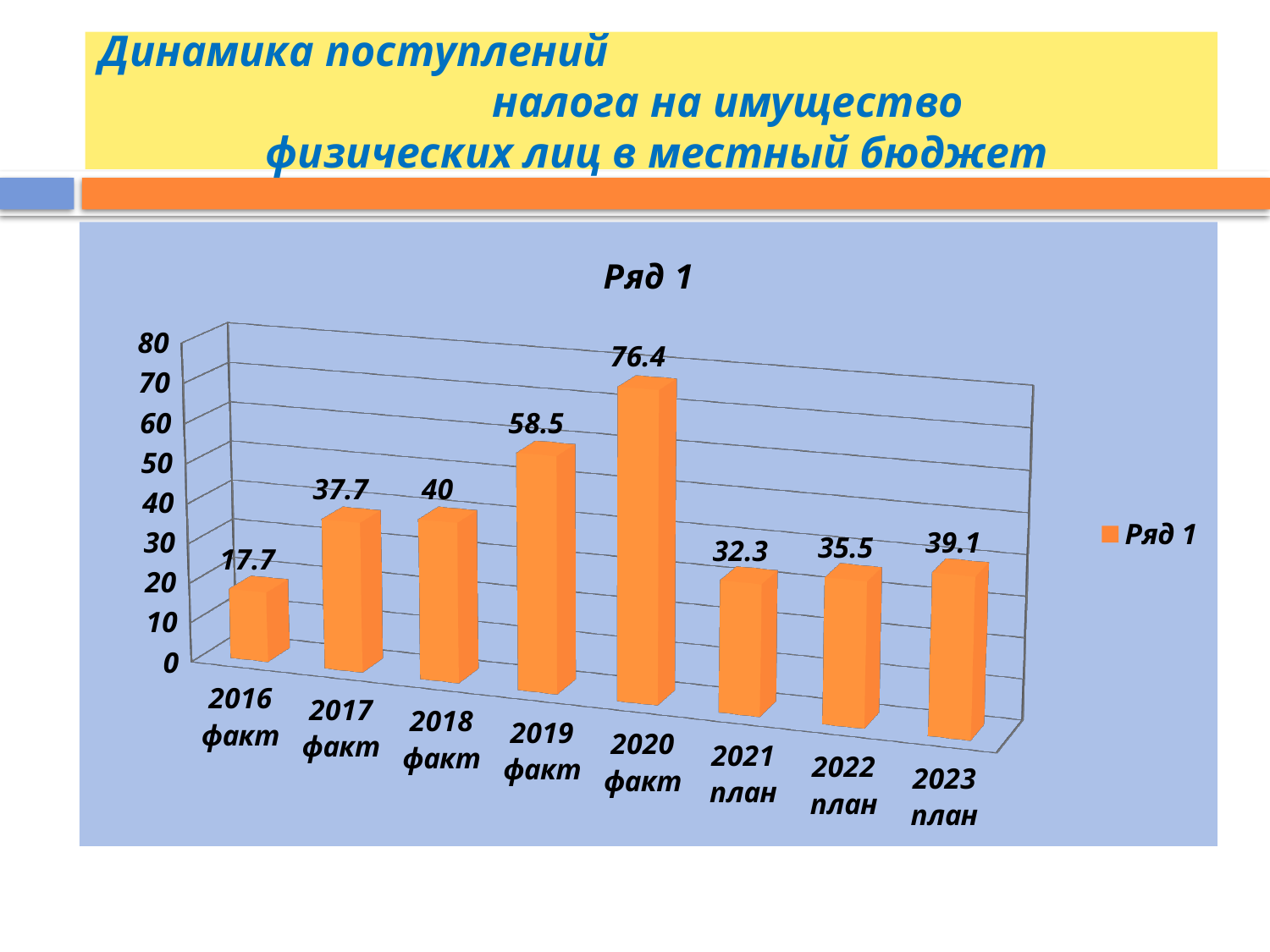
Which category has the highest value? 2020 факт What is the difference between the values for 2020 факт and 2019 факт? 17.9 What is the value for 2022 план? 35.5 Which category has the lowest value? 2016 факт Which is larger, the value for 2018 факт or the value for 2023 план? 2018 факт What is the value for 2020 факт? 76.4 What is the value for 2016 факт? 17.7 Is the value for 2021 план greater or less than 40? less Do the values rise or fall from 2021 план to 2023 план? rise How many categories are shown on the x axis? 8 How many series does the legend list? 1 What kind of chart is shown on the slide? bar chart